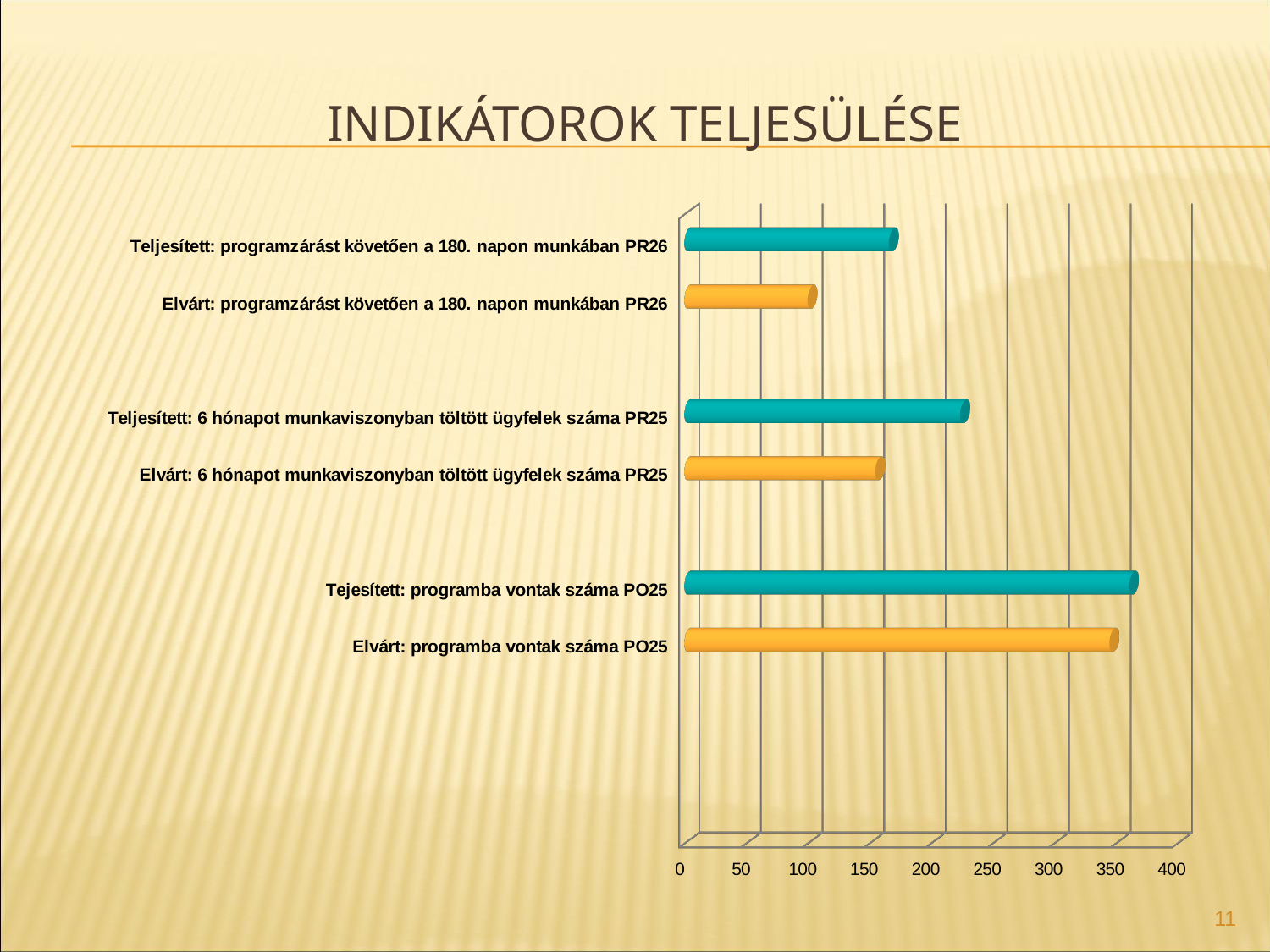
What kind of chart is shown on the slide? bar chart Is the value for 'Elvárt: programzárást követően a 180. napon munkában PR26' greater or less than 150? less Is the value for 'Teljesített: programzárást követően a 180. napon munkában PR26' greater or less than 150? greater What is the title of the slide containing the chart? Indikátorok teljesülése Is the value for 'Teljesített: 6 hónapot munkaviszonyban töltött ügyfelek száma PR25' greater or less than 200? greater Which is larger: the value for 'Teljesített: 6 hónapot munkaviszonyban töltött ügyfelek száma PR25' or 'Elvárt: 6 hónapot munkaviszonyban töltött ügyfelek száma PR25'? Teljesített: 6 hónapot munkaviszonyban töltött ügyfelek száma PR25 Which is larger: the value for 'Teljesített: programzárást követően a 180. napon munkában PR26' or 'Elvárt: programzárást követően a 180. napon munkában PR26'? Teljesített: programzárást követően a 180. napon munkában PR26 Which category has the highest value in the chart? Tejesített: programba vontak száma PO25 Which category has the lowest value in the chart? Elvárt: programzárást követően a 180. napon munkában PR26 How many bars (categories) does the chart show? 6